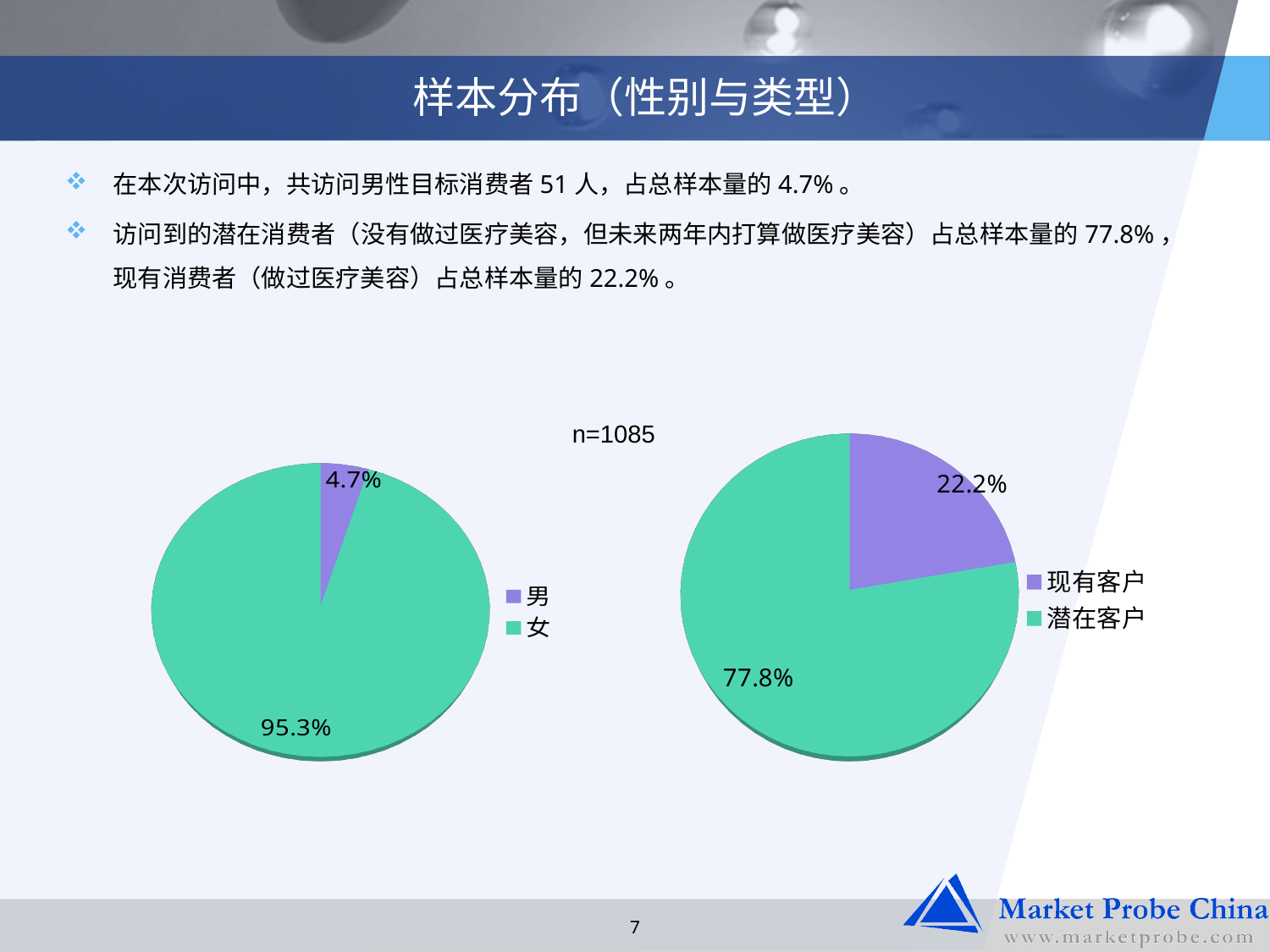
In the right pie chart (customer type), what share is labelled for 潜在客户? 77.8% In the right pie chart (customer type), what is the difference in percentage points between 潜在客户 and 现有客户? 55.6 In the left pie chart (gender), what is the difference in percentage points between 女 and 男? 90.6 In the right pie chart (customer type), which is larger, 现有客户 or 潜在客户? 潜在客户 In the left pie chart (gender), which category has the largest slice? 女 In the right pie chart (customer type), which category has the smallest slice? 现有客户 In the left pie chart (gender), what share is labelled for 男? 4.7% In the left pie chart (gender), what share is labelled for 女? 95.3% What type of chart is used on the left of the slide? Pie chart How many categories does the legend of the right pie chart (customer type) list? 2 In the right pie chart (customer type), what share is labelled for 现有客户? 22.2% What sample size (n) is shown between the two pie charts? n=1085